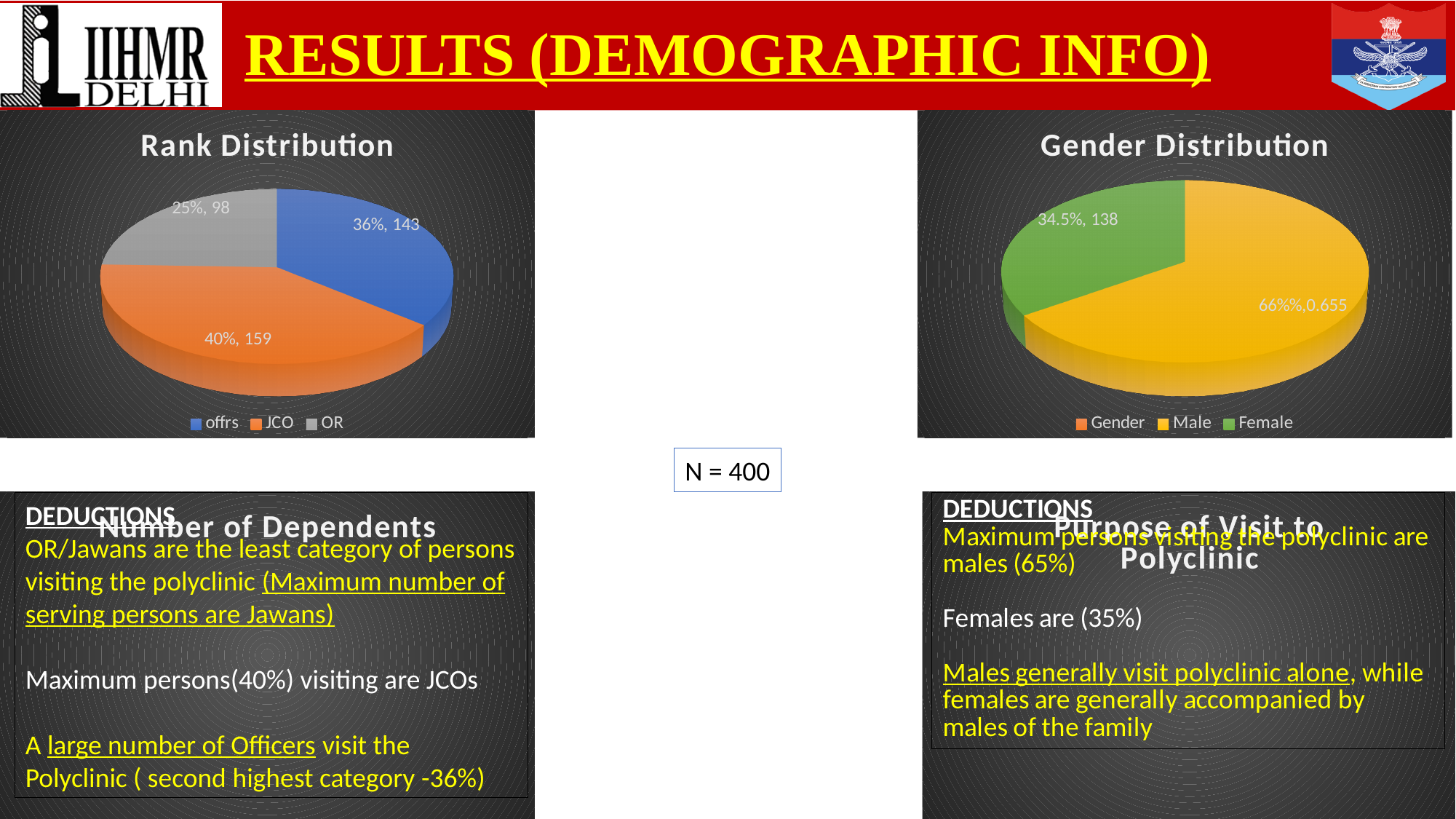
In the Rank Distribution chart, which category has the largest slice? JCO In the Rank Distribution chart, which is larger, the offrs count or the OR count? offrs What kind of chart is the Rank Distribution chart? pie chart How many categories does the Rank Distribution pie chart show? 3 In the Rank Distribution chart, what is the count for JCO? 159 In the Rank Distribution chart, what is the count for offrs? 143 In the Rank Distribution chart, what is the difference between the JCO count and the OR count? 61 In the Gender Distribution chart, what percentage share does Female have? 34.5% How many entries does the legend of the Gender Distribution chart list? 3 In the Gender Distribution chart, what is the count for Female? 138 In the Rank Distribution chart, what percentage share does OR have? 25% In the Rank Distribution chart, which category has the smallest slice? OR